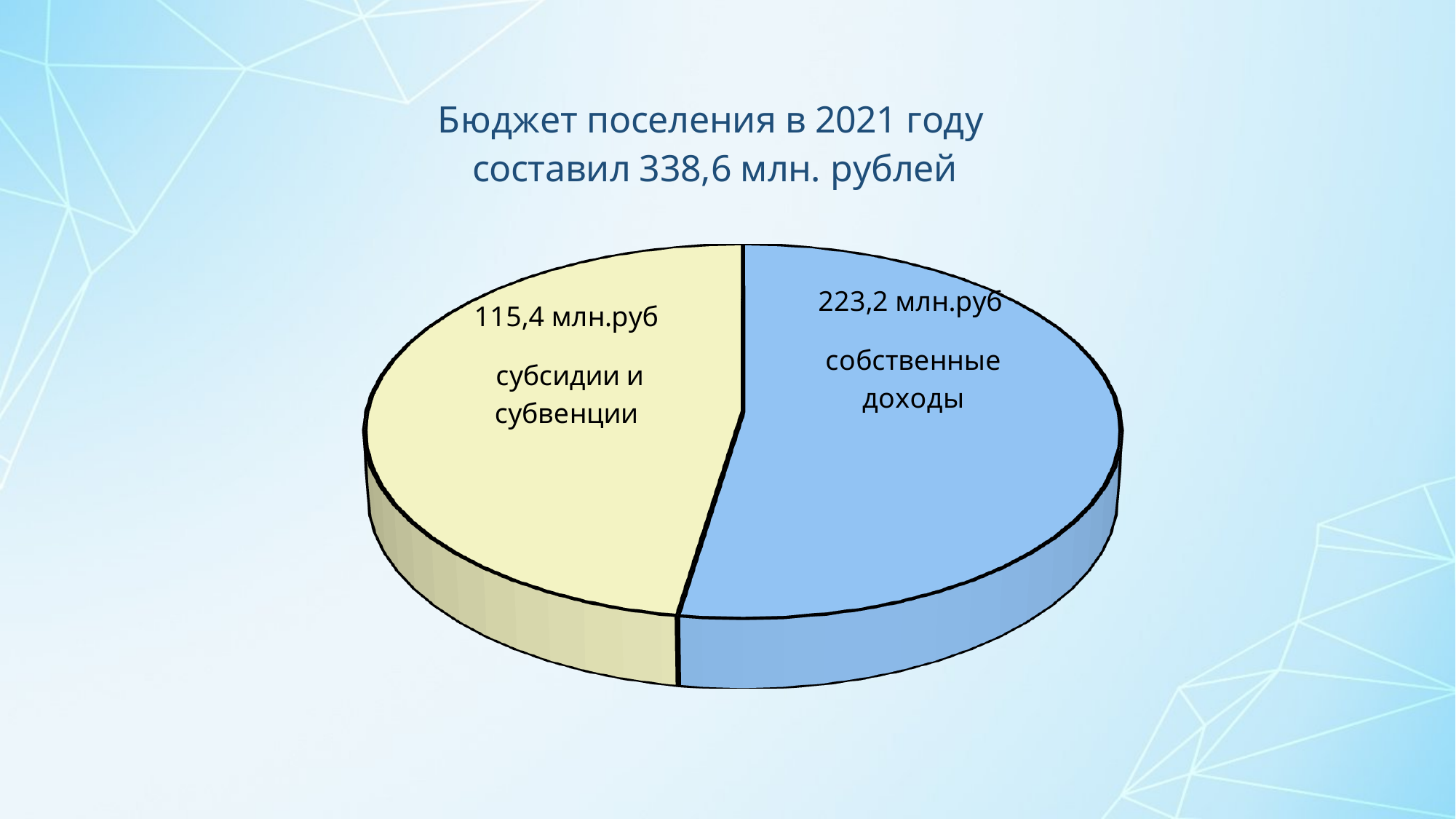
What is the difference between собственные доходы and субсидии и субвенции? 107,8 млн.руб Which category has the smallest slice of the pie? субсидии и субвенции Which is larger: собственные доходы or субсидии и субвенции? собственные доходы What is the total budget of the settlement in 2021 according to the slide title? 338,6 млн. рублей What type of chart is shown on the slide? Pie chart What share of the total budget (338,6 млн. рублей) do собственные доходы make up? 65,9% How many slices does the pie chart have? 2 What is the value for собственные доходы? 223,2 млн.руб What colour is the slice for собственные доходы? Blue Which category has the largest slice of the pie? собственные доходы What is the value for субсидии и субвенции? 115,4 млн.руб What is the title of the chart? Бюджет поселения в 2021 году составил 338,6 млн. рублей